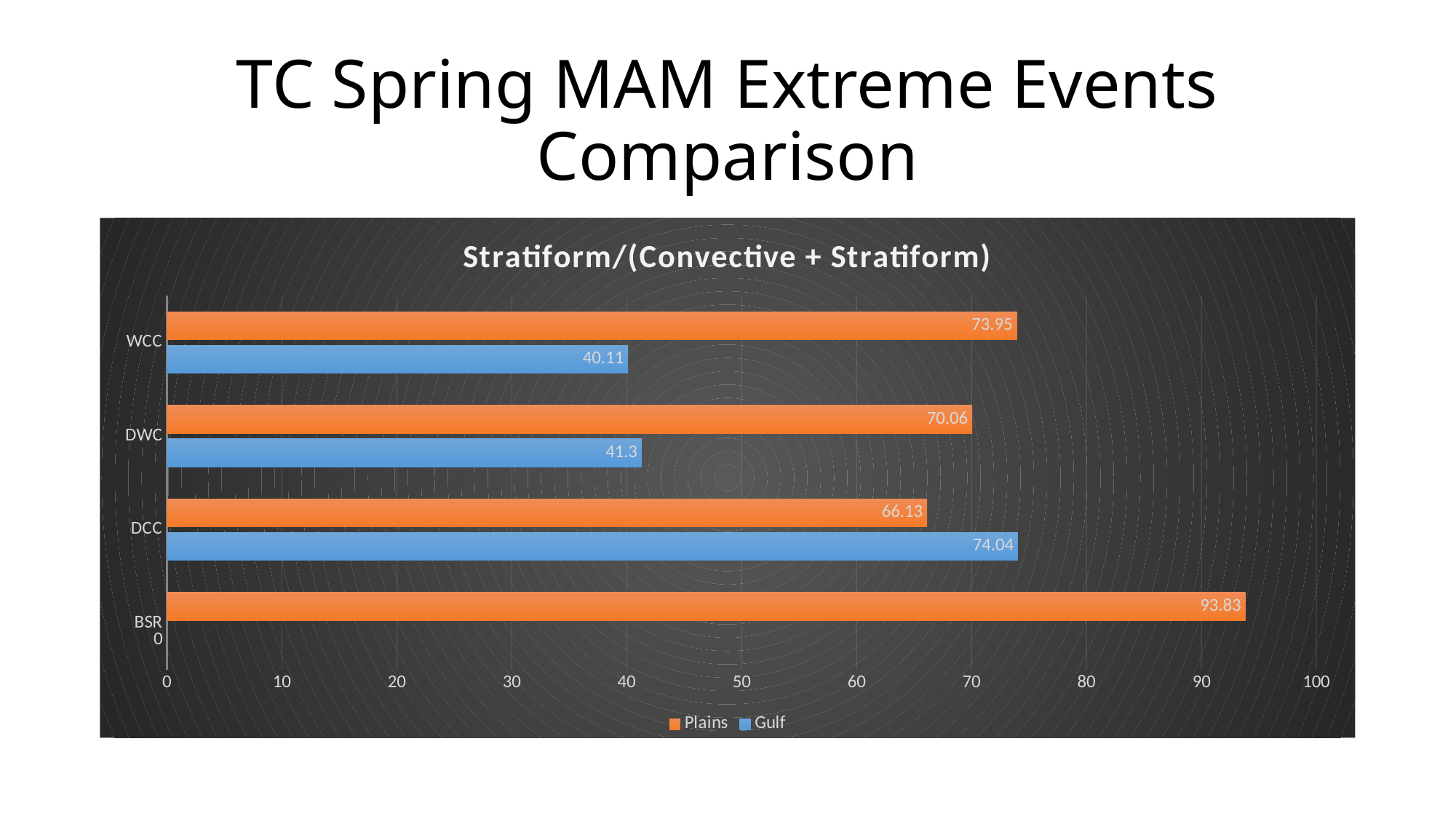
Is the Plains value for DWC greater or less than 60? greater How many series does the legend list? 2 For DCC, which series has the larger value, Plains or Gulf? Gulf What is the Gulf value for DCC? 74.04 What is the Plains value for WCC? 73.95 What is the Plains value for BSR? 93.83 What is the Gulf value for DWC? 41.3 How many categories are shown on the y axis? 4 Which category has the lowest Gulf value? BSR Which category has the highest Plains value? BSR What is the difference between the Plains and Gulf values for WCC? 33.84 What kind of chart is shown on the slide? Bar chart